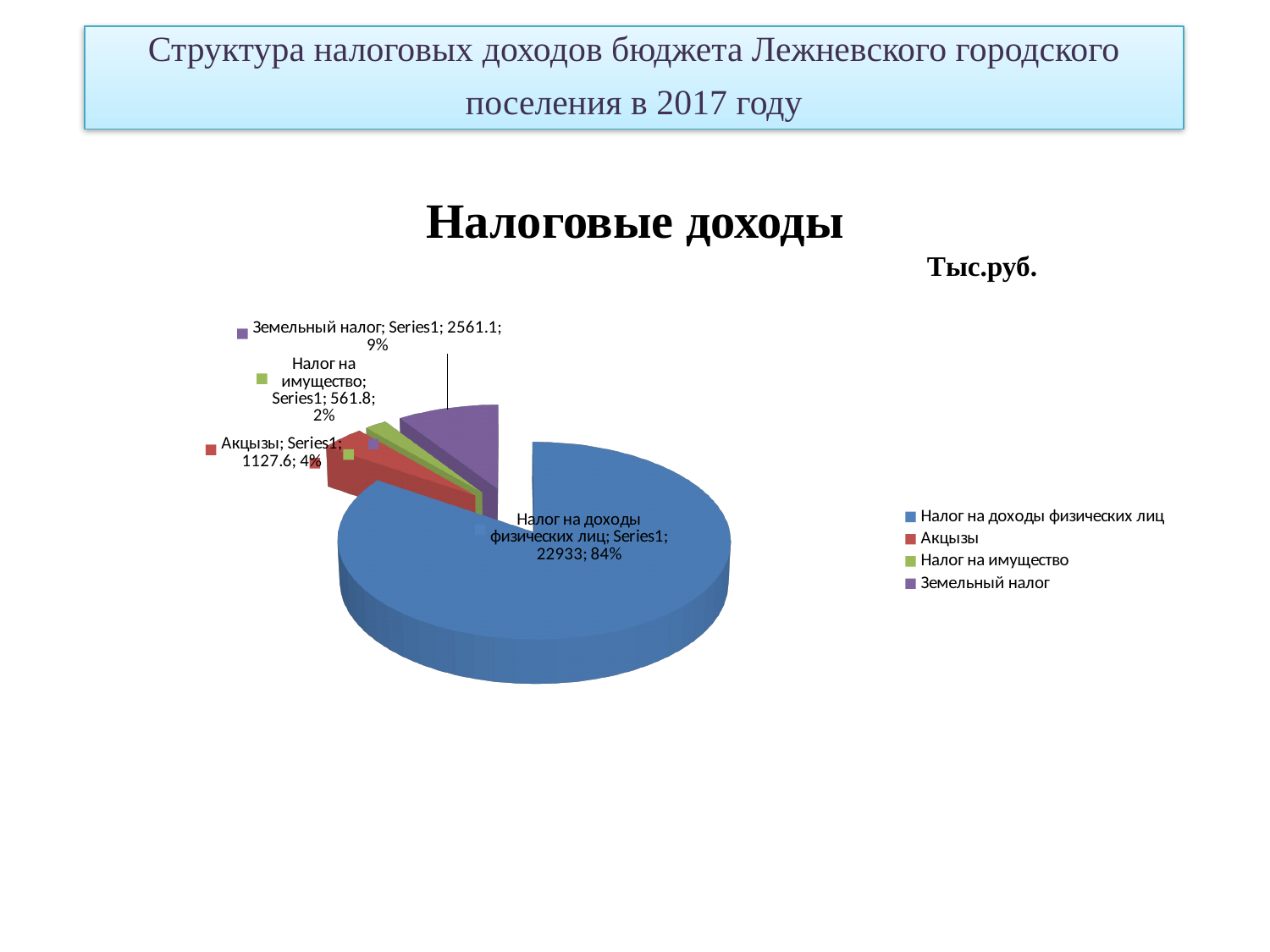
What is the value for Налог на имущество? 561.8 What share of the pie does Земельный налог represent? 9% Which category has the smallest slice? Налог на имущество What is the value for Земельный налог? 2561.1 What share of the pie does Налог на доходы физических лиц represent? 84% What kind of chart is shown on the slide? pie chart How many slices does the pie chart have? 4 Which is larger, Акцызы or Земельный налог? Земельный налог What is the value for Акцызы? 1127.6 What is the value for Налог на доходы физических лиц? 22933 Which category has the largest slice? Налог на доходы физических лиц What is the title of the chart? Налоговые доходы